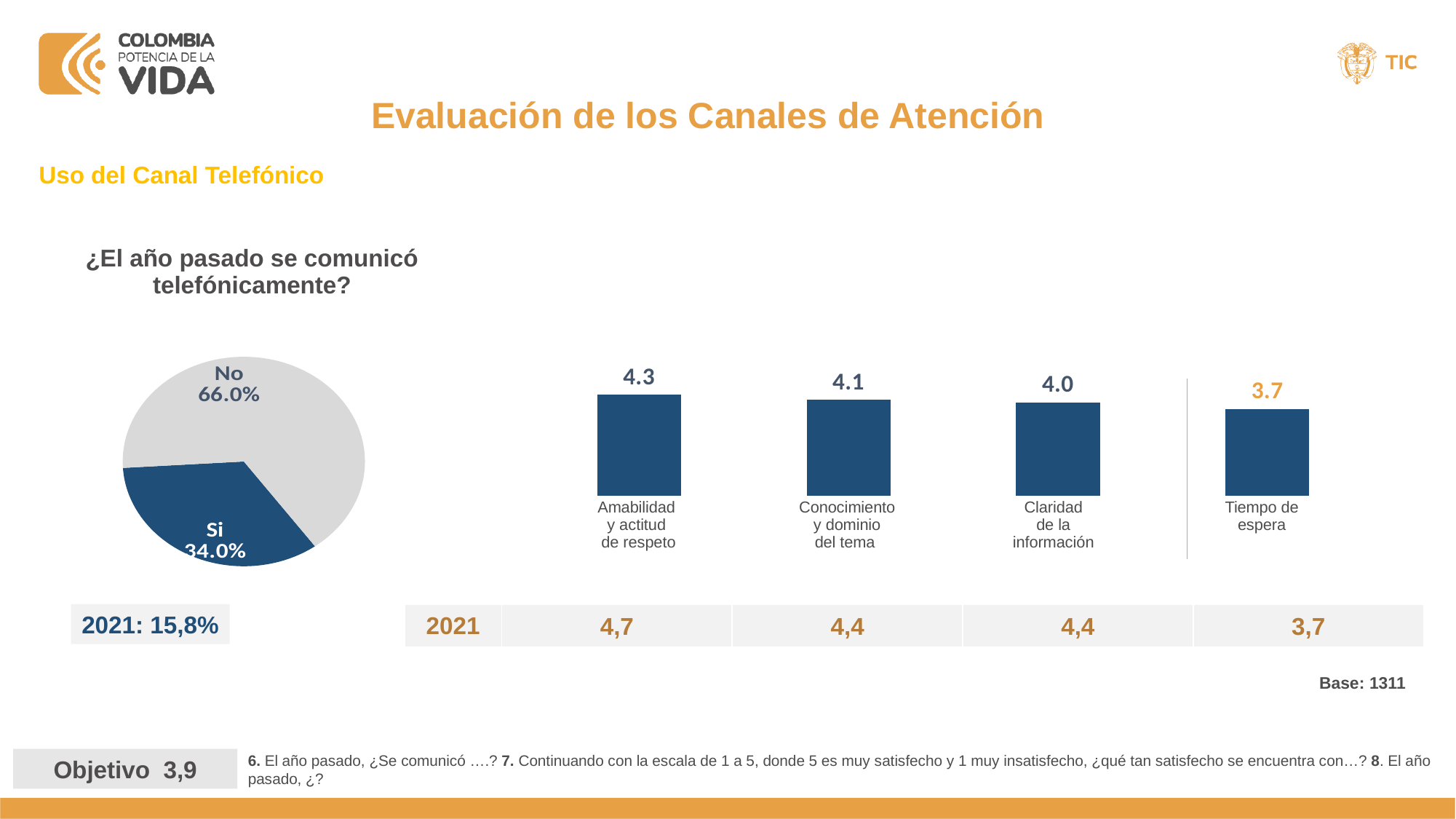
How many categories are shown in the bar chart on the right? 4 In the bar chart on the right, which category has the highest value? Amabilidad y actitud de respeto In the pie chart '¿El año pasado se comunicó telefónicamente?', what share of respondents answered 'No'? 66.0% In the bar chart on the right, which category has the lowest value? Tiempo de espera How many slices does the pie chart on the left have? 2 In the bar chart on the right, what is the value for 'Amabilidad y actitud de respeto'? 4.3 In the bar chart on the right, what is the difference between 'Amabilidad y actitud de respeto' and 'Claridad de la información'? 0.3 What type of chart is the chart on the left of the slide? Pie chart In the pie chart '¿El año pasado se comunicó telefónicamente?', what share of respondents answered 'Si'? 34.0% In the bar chart on the right, what is the value for 'Conocimiento y dominio del tema'? 4.1 In the pie chart on the left, which answer has the larger slice, 'Si' or 'No'? No In the bar chart on the right, what is the value for 'Tiempo de espera'? 3.7